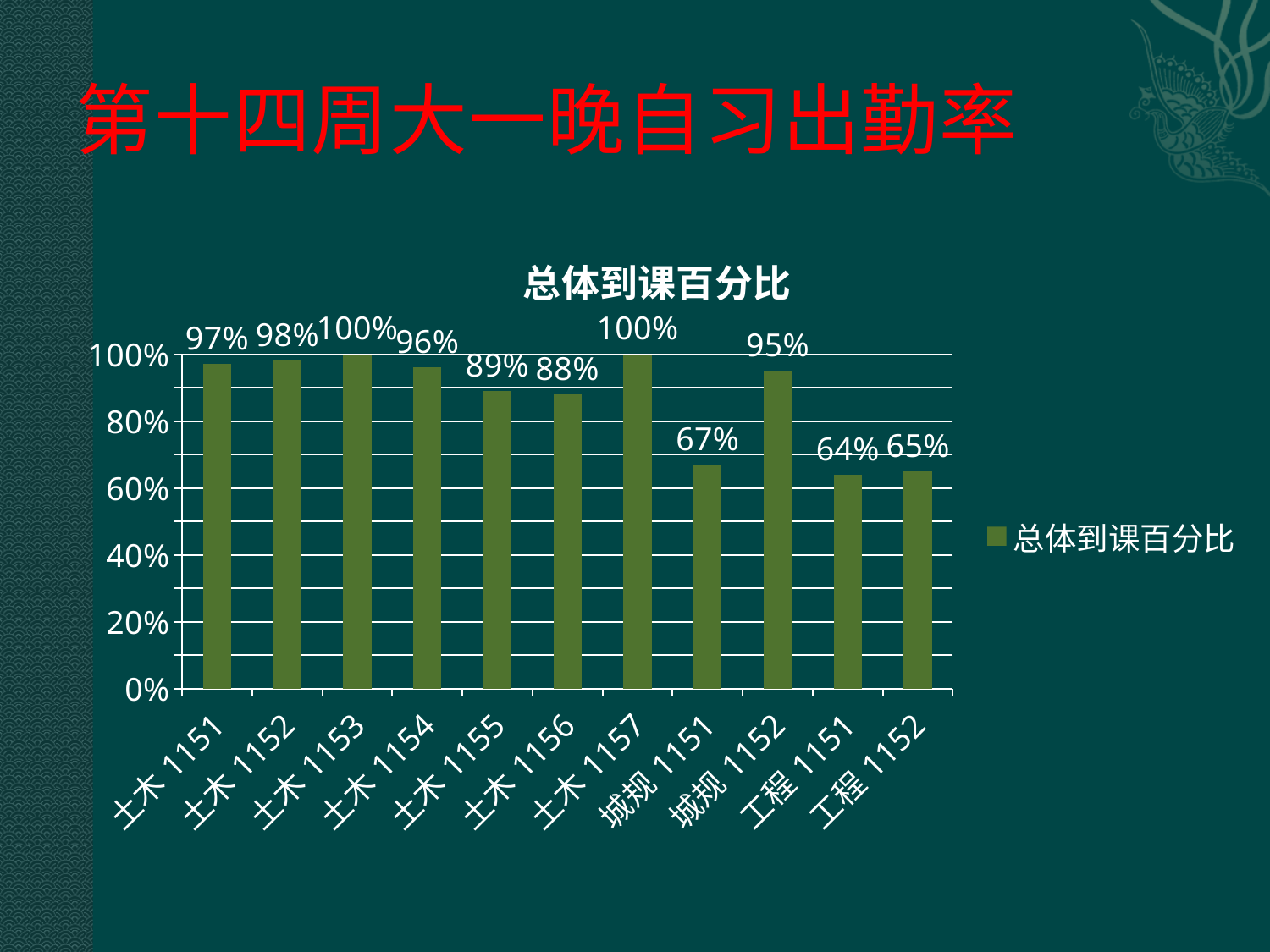
What is the value for 工程1152? 65% Which is larger, the value for 土木1155 or the value for 城规1151? 土木1155 What is the value for 土木1151? 97% What is the highest value shown in the chart? 100% What is the value for 土木1156? 88% What kind of chart is shown on the slide? bar chart What is the title of the chart? 总体到课百分比 How many categories are shown on the x axis? 11 What is the value for 城规1151? 67% Which category has the lowest value? 工程1151 Is the value for 工程1151 greater or less than 80%? less What is the difference between the values for 土木1152 and 城规1152? 3%